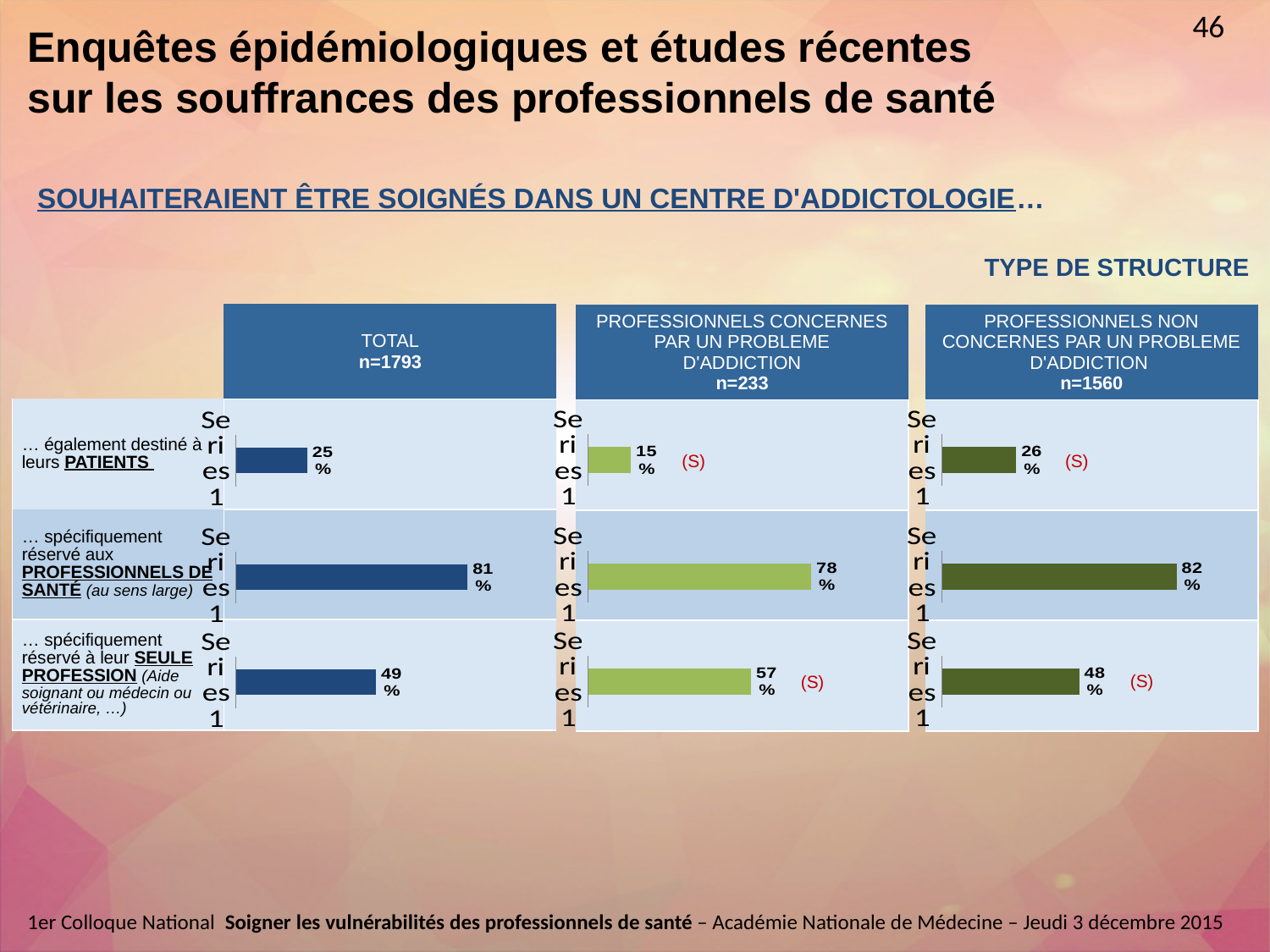
In the TOTAL column, what is the difference between the PROFESSIONNELS DE SANTÉ value and the PATIENTS value? 56% For the option 'également destiné à leurs PATIENTS', which column has the larger value: PROFESSIONNELS CONCERNES or PROFESSIONNELS NON CONCERNES? PROFESSIONNELS NON CONCERNES What kind of chart is used in each cell of the table? bar chart In the PROFESSIONNELS CONCERNES PAR UN PROBLEME D'ADDICTION column, what is the value for a centre specifically reserved for PROFESSIONNELS DE SANTÉ? 78% In the PROFESSIONNELS NON CONCERNES column, which option has the lowest percentage? également destiné à leurs PATIENTS In the TOTAL column, what percentage would like a centre also intended for their PATIENTS? 25% For the option 'spécifiquement réservé à leur SEULE PROFESSION', what is the difference between the PROFESSIONNELS CONCERNES value and the PROFESSIONNELS NON CONCERNES value? 9% In the TOTAL column, which of the three options has the highest percentage? spécifiquement réservé aux PROFESSIONNELS DE SANTÉ What is the sample size (n) shown for the TOTAL column? n=1793 In the PROFESSIONNELS NON CONCERNES PAR UN PROBLEME D'ADDICTION column, what is the value for a centre reserved for their SEULE PROFESSION? 48% How many columns (types of structure) are shown in the table? 3 In the PROFESSIONNELS CONCERNES PAR UN PROBLEME D'ADDICTION column, what is the value for a centre also intended for their PATIENTS? 15%